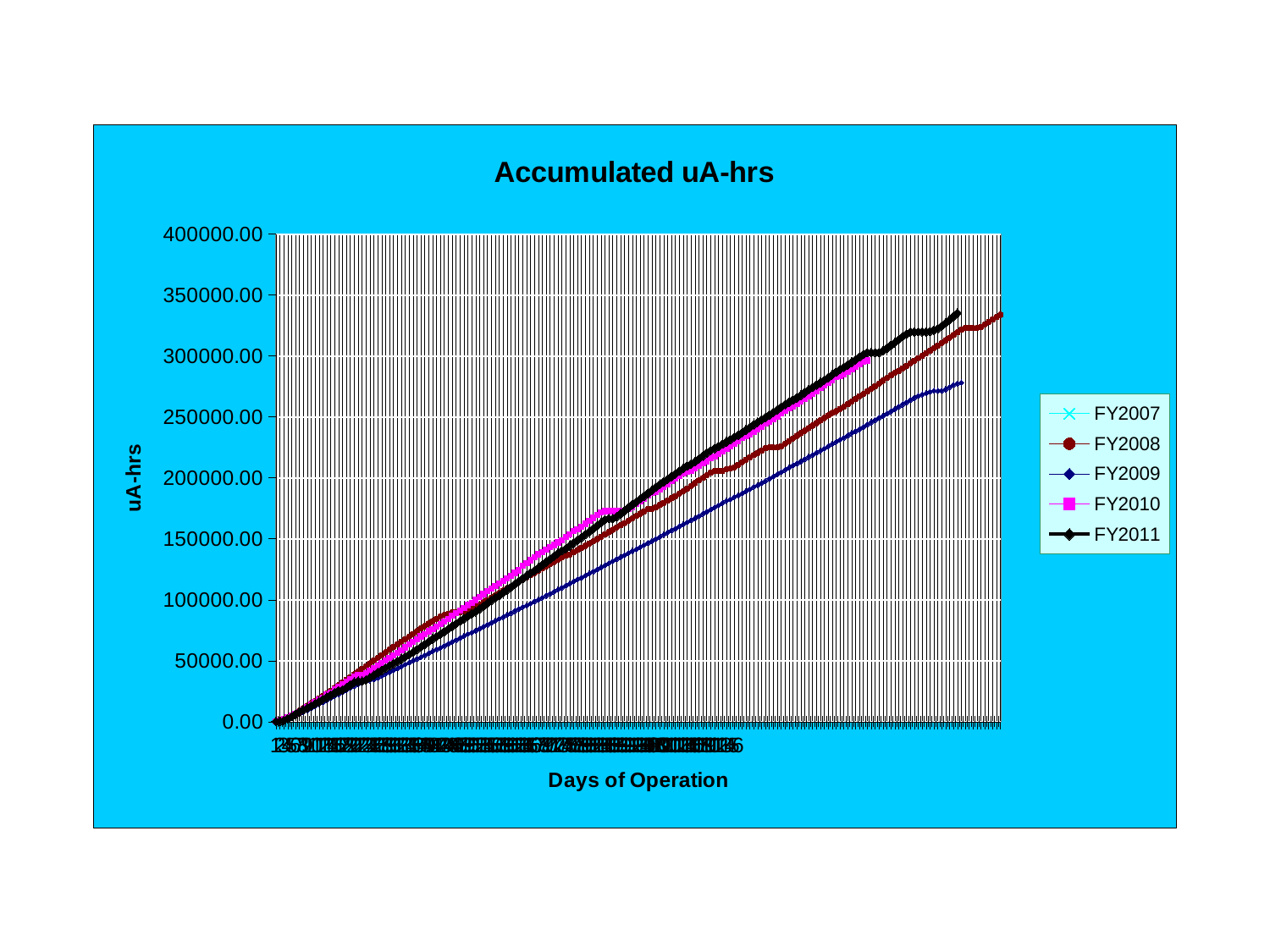
What is the label of the x axis? Days of Operation What kind of chart is shown on the slide? line chart Among the visible lines FY2008, FY2009, FY2010 and FY2011, which ends at the lowest value? FY2009 At the end of their lines, which reaches a higher value, FY2011 or FY2009? FY2011 What is the title of the chart? Accumulated uA-hrs Is the final value of the FY2009 line greater or less than 300000.00? less Do the plotted lines rise or fall as Days of Operation increase? rise Is the final value of the FY2008 line greater or less than 300000.00? greater Is the final value of the FY2011 line greater or less than 300000.00? greater How many series does the legend list? 5 At the end of their lines, which reaches a higher value, FY2008 or FY2009? FY2008